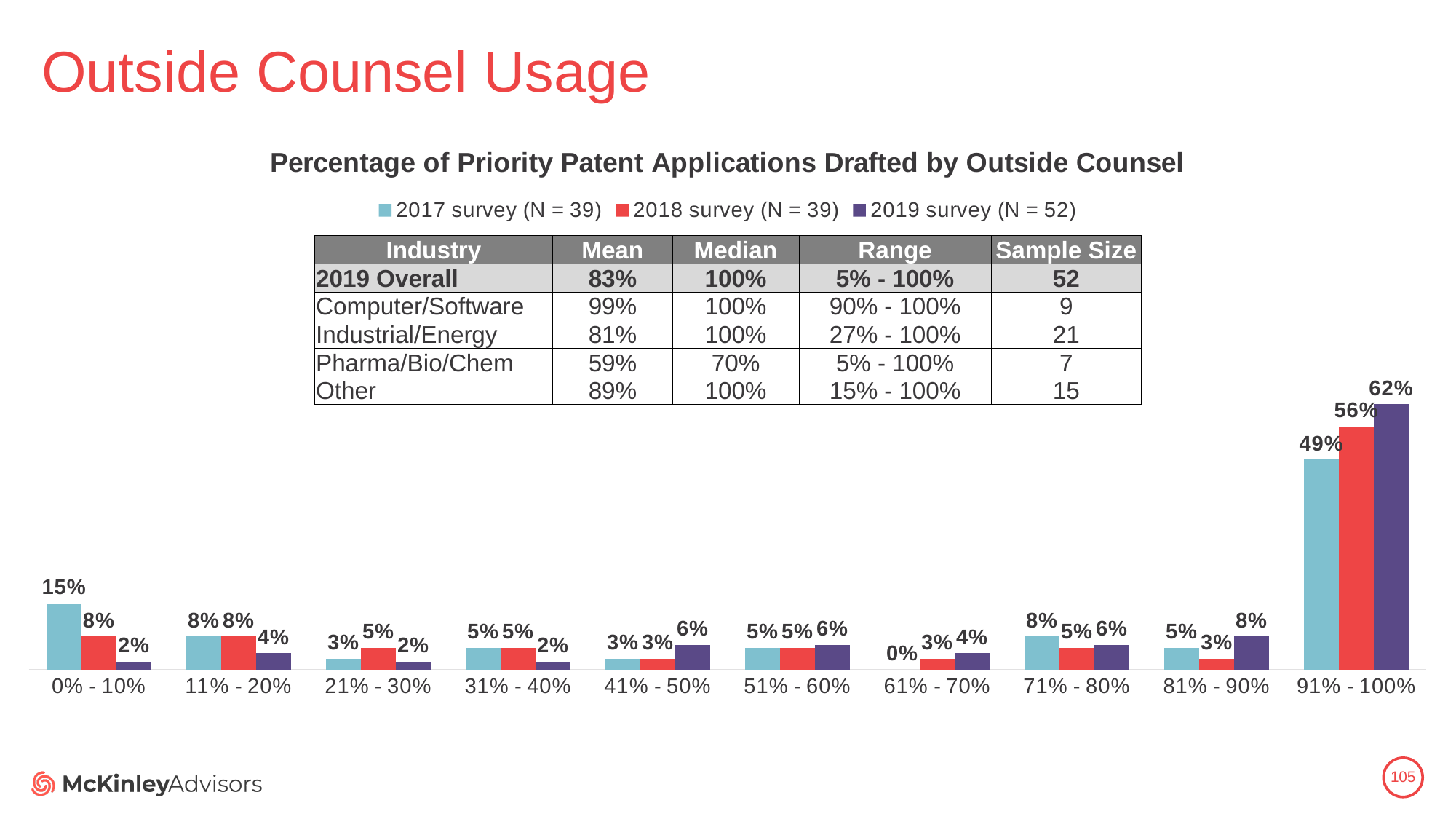
In the 81% - 90% category, which is larger: the 2019 survey value or the 2018 survey value? 2019 survey Which category has the lowest value for the 2017 survey? 61% - 70% What is the value for the 2017 survey in the 0% - 10% category? 15% What is the difference between the 2019 survey and 2017 survey values in the 91% - 100% category? 13% How many series does the legend list? 3 What is the title of the chart? Percentage of Priority Patent Applications Drafted by Outside Counsel What sample size does the legend give for the 2019 survey? N = 52 What is the value for the 2019 survey in the 91% - 100% category? 62% Which category has the highest value for the 2018 survey? 91% - 100% How many categories are shown on the x axis? 10 What is the value for the 2018 survey in the 21% - 30% category? 5% What kind of chart is shown? bar chart